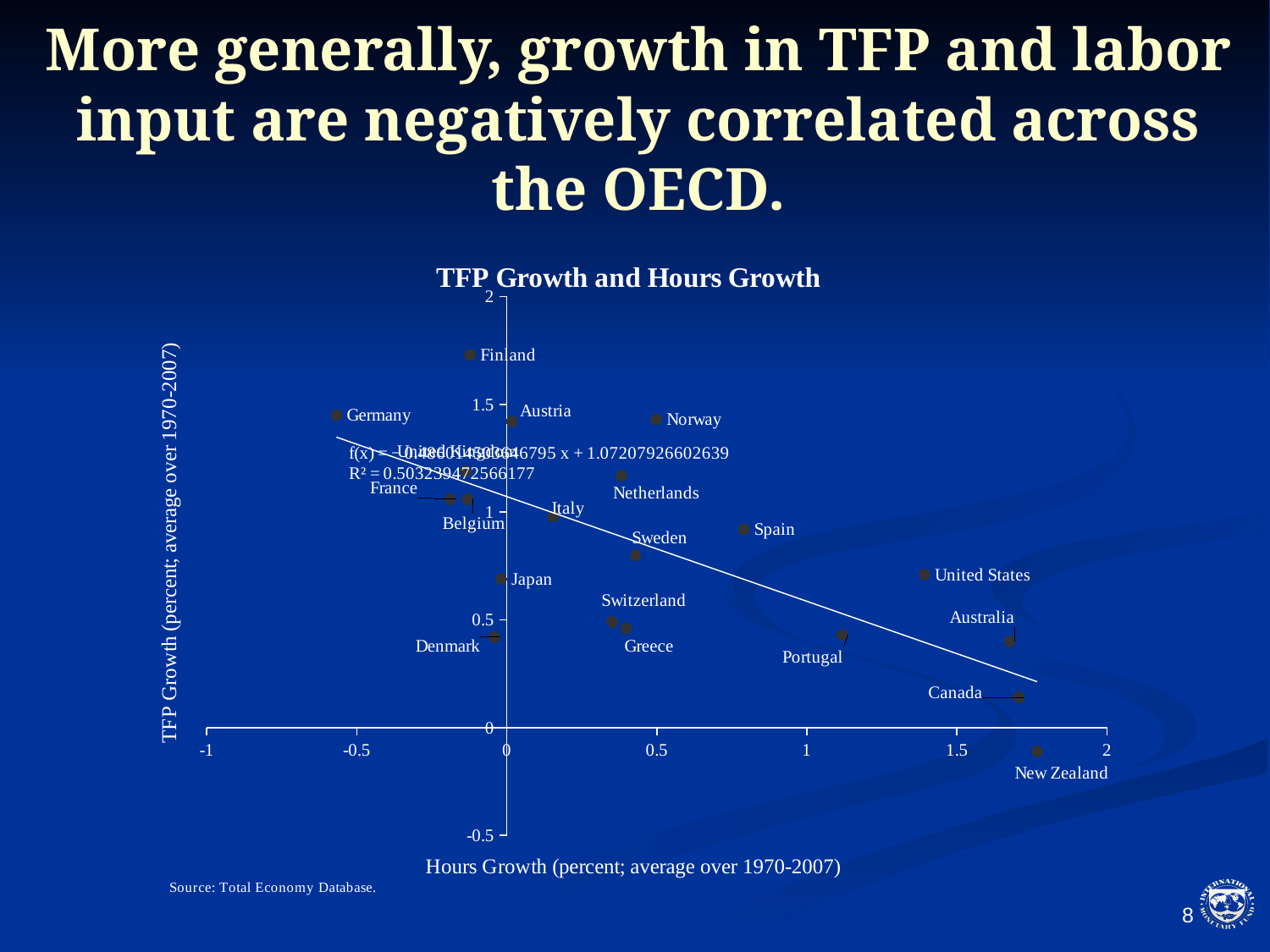
Which has the higher TFP growth, Finland or Norway? Finland Is the TFP growth value for Canada greater or less than 0.5? less Which country has the lowest hours growth in the chart? Germany As hours growth increases along the x axis, does the fitted trend line rise or fall? Fall Is the hours growth value for the United States greater or less than 1? greater Is the TFP growth value for Finland greater or less than 1.5? greater What is the label of the horizontal axis of the chart? Hours Growth (percent; average over 1970-2007) Which country has the lowest TFP growth in the chart? New Zealand Which country has the highest TFP growth in the chart? Finland What kind of chart is shown on the slide? Scatter chart What is the title of the chart? TFP Growth and Hours Growth